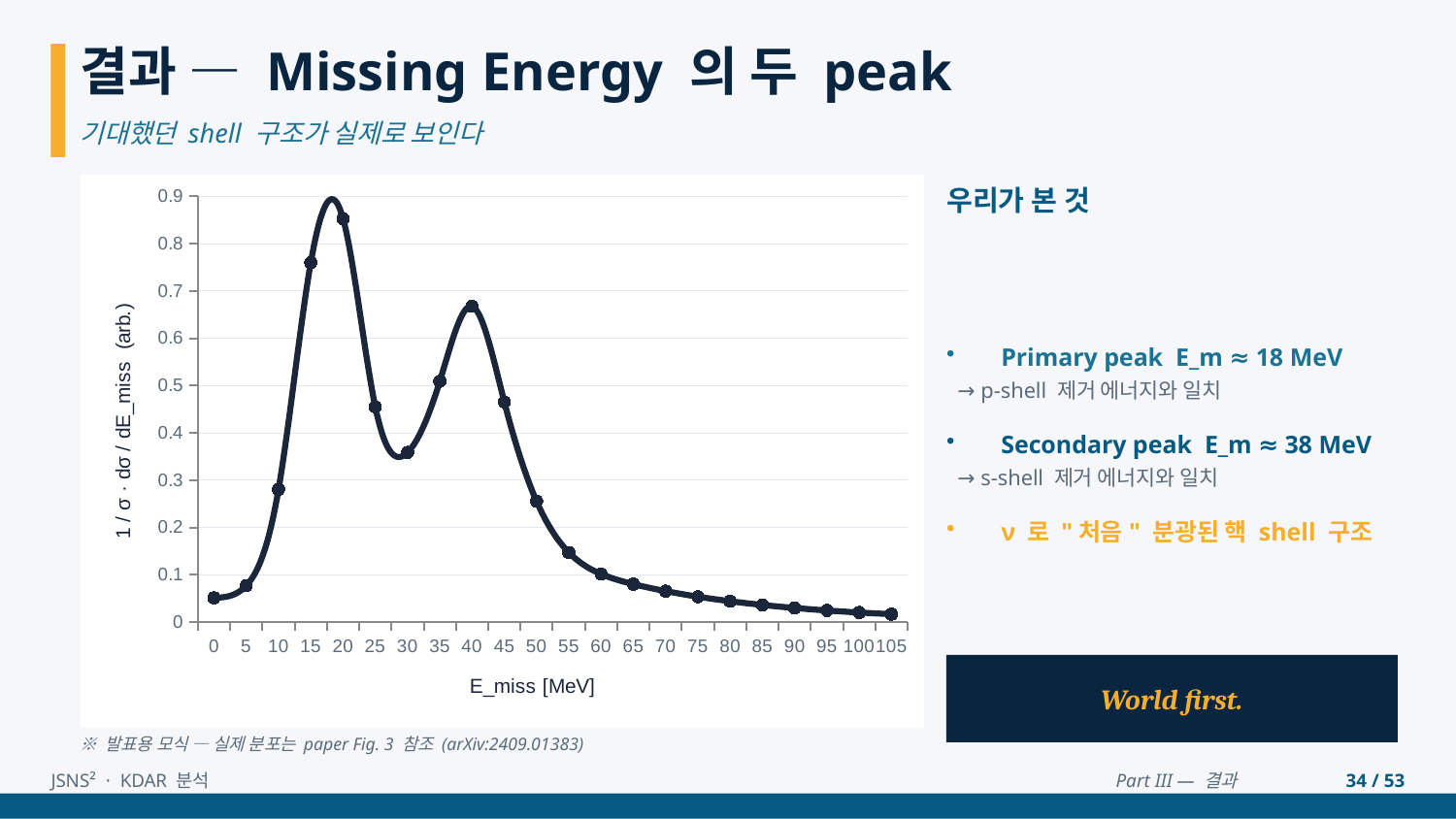
At which E_miss value does the plotted curve reach its highest point? 20 Is the value at E_miss = 30 greater or less than 0.4? less How many data points are plotted on the curve? 22 Is the value at E_miss = 40 greater or less than 0.6? greater Is the value at E_miss = 15 greater or less than 0.7? greater Do the plotted values rise or fall as E_miss increases from 40 to 105? fall What is the label of the y axis? 1 / σ · dσ / dE_miss (arb.) At which E_miss value is the plotted value lowest? 105 What kind of chart is shown on the slide? line chart What is the label of the x axis? E_miss [MeV] Which is larger, the value at E_miss = 20 or the value at E_miss = 40? E_miss = 20